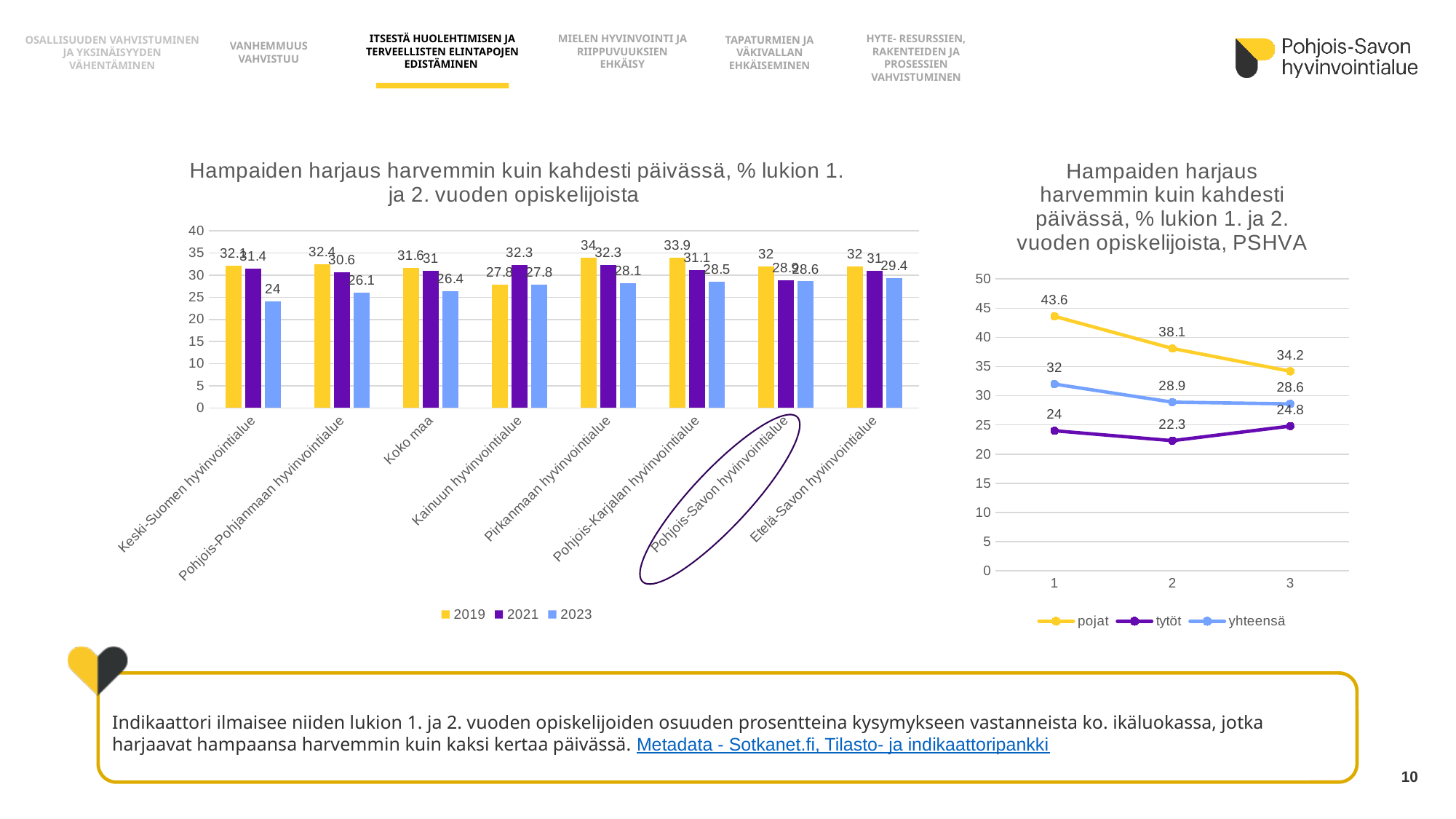
In the right chart (PSHVA), what is the value for pojat at point 1? 43.6 In the left chart, what is the difference between the 2019 and 2023 values for Pohjois-Pohjanmaan hyvinvointialue? 6.3 In the left chart, what is the 2023 value for Keski-Suomen hyvinvointialue? 24 What kind of chart is the chart on the left of the slide? Bar chart In the left chart, how many categories are shown on the x axis? 8 In the left chart, which category has the highest 2023 value? Etelä-Savon hyvinvointialue In the left chart, how many series does the legend list? 3 In the left chart, which category has the lowest 2019 value? Kainuun hyvinvointialue In the right chart (PSHVA), what is the value for tytöt at point 2? 22.3 In the left chart, what is the 2019 value for Pirkanmaan hyvinvointialue? 34 In the right chart (PSHVA), does the pojat series rise or fall from point 1 to point 3? Fall In the right chart (PSHVA), which series is larger at point 3, pojat or yhteensä? pojat